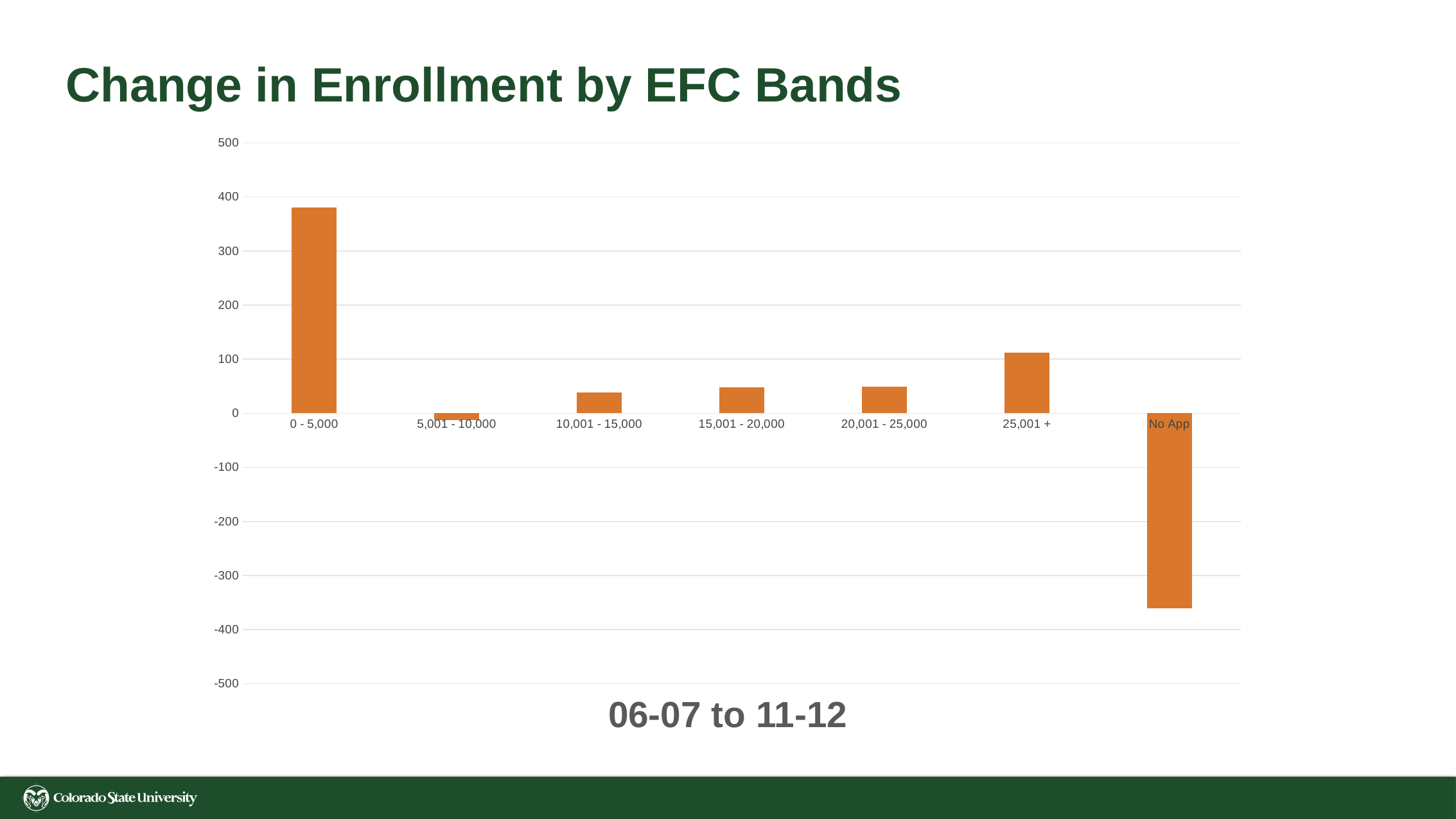
Which EFC band has the highest change in enrollment? 0 - 5,000 Which is larger, the value for 0 - 5,000 or the value for 25,001 +? 0 - 5,000 Is the value for 10,001 - 15,000 greater or less than 100? less How many EFC band categories are plotted on the chart? 7 Is the value for 0 - 5,000 greater or less than 300? greater What kind of chart is shown on the slide? bar chart What period is shown in the text below the chart? 06-07 to 11-12 Is the value for 5,001 - 10,000 greater or less than 0? less Which EFC band has the lowest change in enrollment? No App Which is larger, the value for 10,001 - 15,000 or the value for 25,001 +? 25,001 +